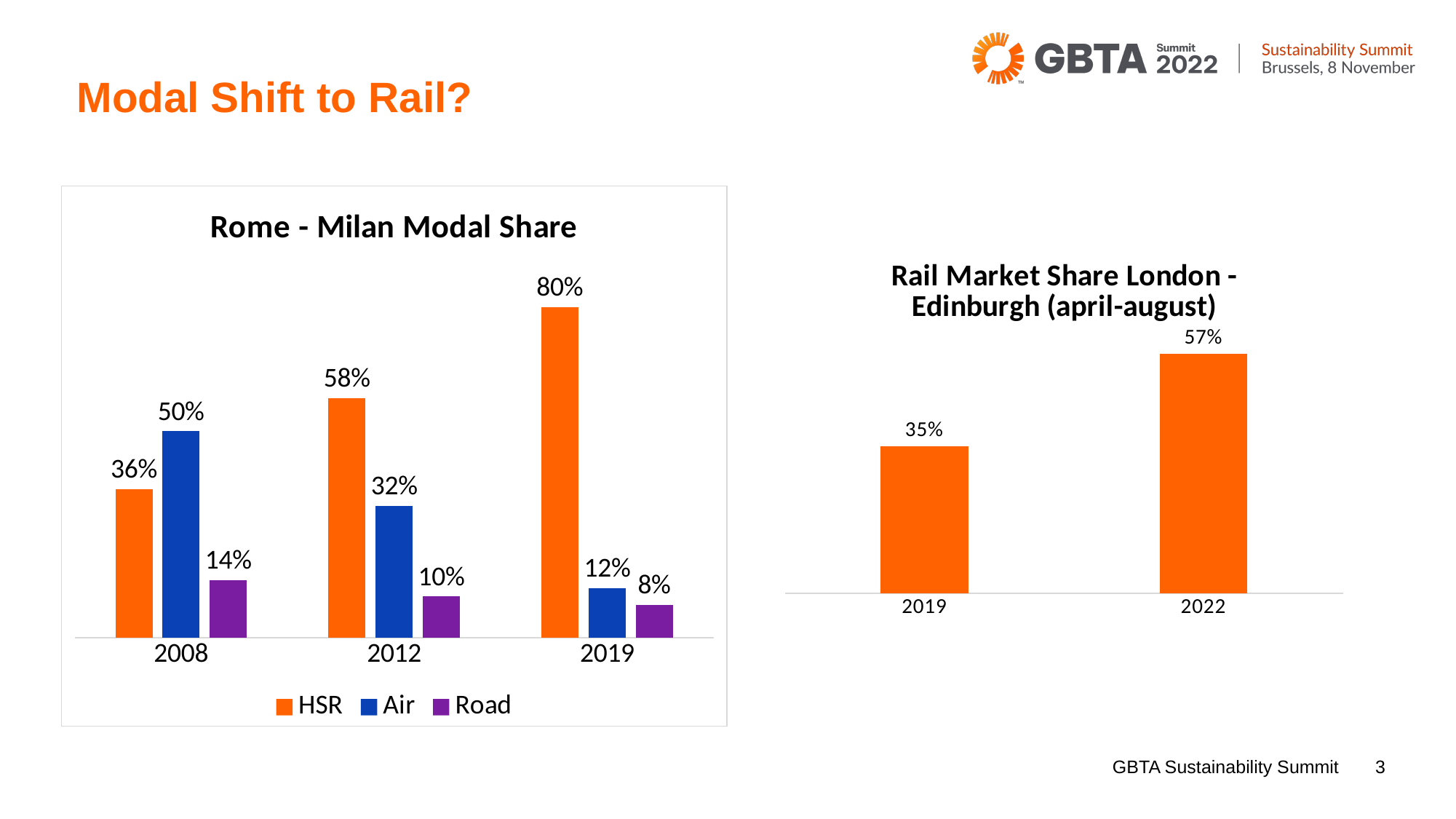
In the Rome - Milan Modal Share chart, how does the Air value change from 2008 to 2019? It falls In the Rail Market Share London - Edinburgh chart, what is the value for 2022? 57% In the Rome - Milan Modal Share chart, which year has the highest HSR value? 2019 What kind of chart is the Rail Market Share London - Edinburgh chart? Bar chart In the Rome - Milan Modal Share chart, what is the difference between the HSR and Air values in 2012? 26% In the Rome - Milan Modal Share chart, what is the HSR value for 2019? 80% In the Rome - Milan Modal Share chart, which year has the lowest Road value? 2019 In the Rome - Milan Modal Share chart, how many series does the legend list? 3 In the Rail Market Share London - Edinburgh chart, what is the difference between the 2022 and 2019 values? 22% In the Rome - Milan Modal Share chart, which is larger in 2008, HSR or Air? Air In the Rome - Milan Modal Share chart, what is the Road value for 2012? 10% In the Rome - Milan Modal Share chart, what is the Air value for 2008? 50%